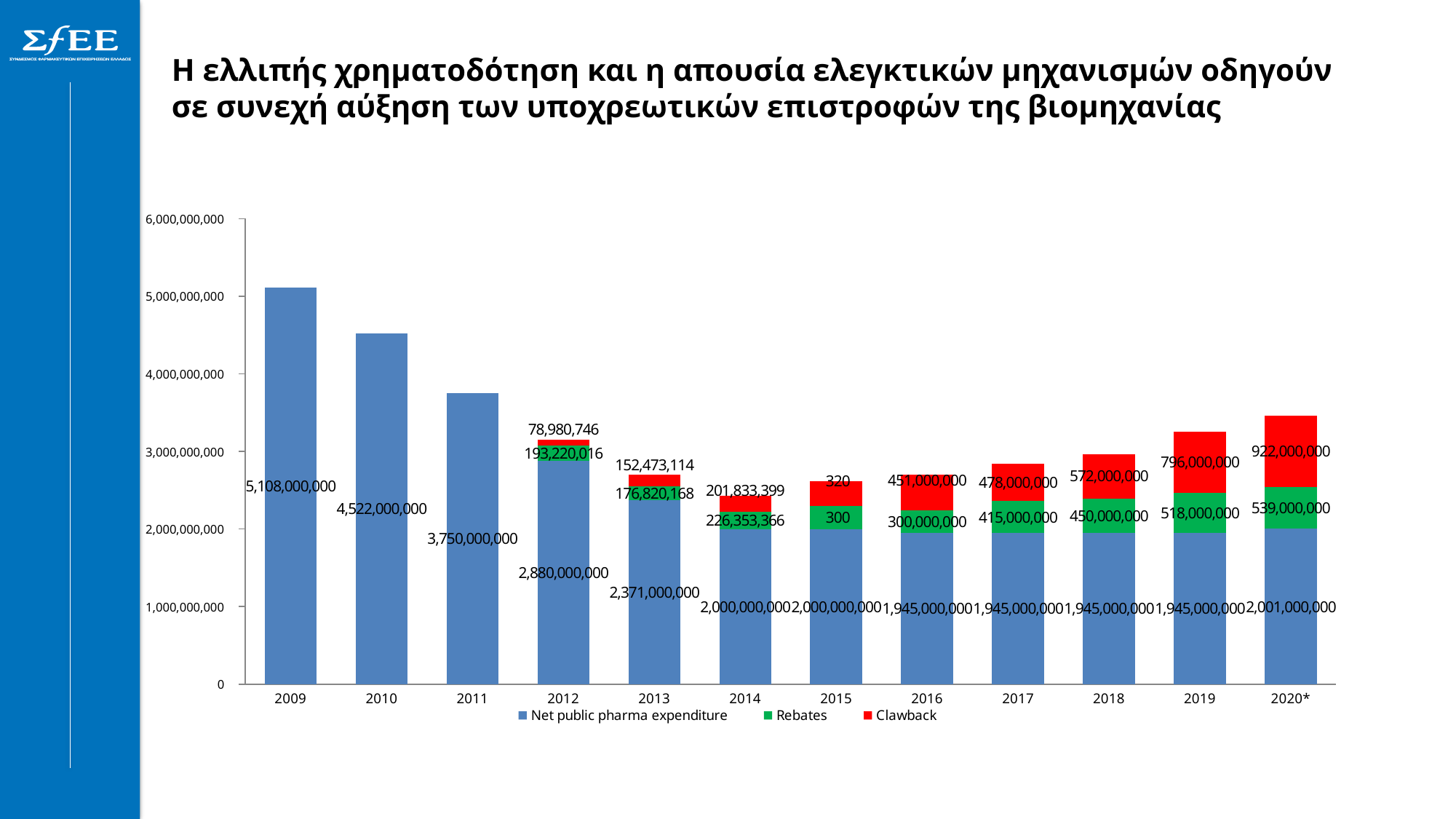
What is the Rebates value for 2019? 518,000,000 What is the total of the stacked bar for 2020*? 3,462,000,000 What is the Clawback value for 2020*? 922,000,000 What kind of chart is shown on the slide? Stacked bar chart Which year has the highest Clawback value? 2020* What is the Rebates value for 2012? 193,220,016 What is the difference between the Clawback values for 2020* and 2019? 126,000,000 Which year has the highest Net public pharma expenditure? 2009 How many years are shown on the x axis? 12 How many series does the legend list? 3 What is the Net public pharma expenditure value for 2009? 5,108,000,000 In 2018, which is larger: Rebates or Clawback? Clawback